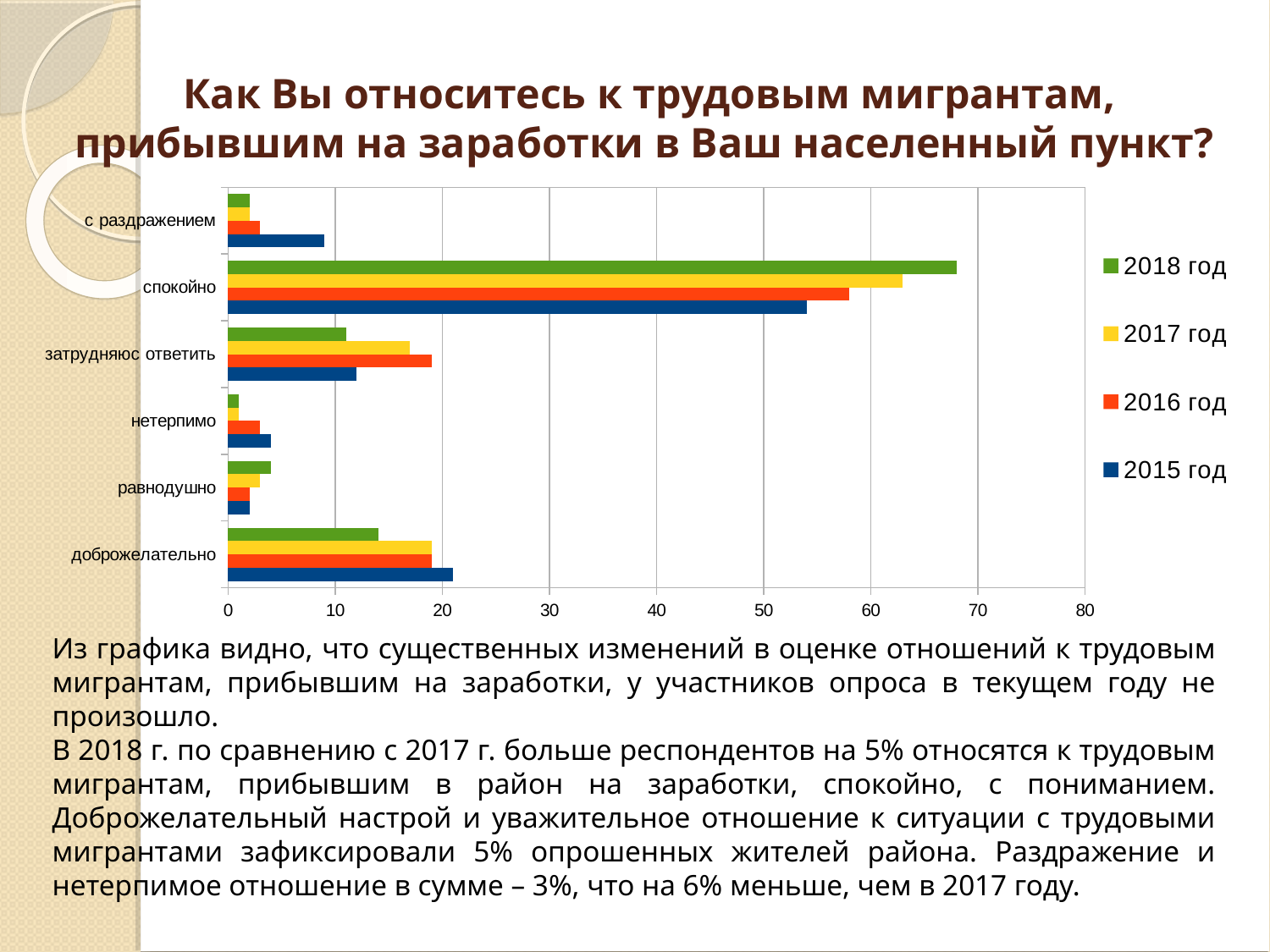
What colour represents 2018 год in the chart? green Is the value for спокойно in 2015 год greater or less than 60? less Is the value for затрудняюс ответить in 2016 год greater or less than 10? greater Which category has the highest value for 2018 год? спокойно Which category has the lowest value for 2015 год? равнодушно What kind of chart is shown on the slide? bar chart How many answer categories are shown on the chart? 6 Is the value for с раздражением in 2015 год greater or less than 5? greater For доброжелательно, which year has the larger value: 2018 год or 2015 год? 2015 год How many series does the legend list? 4 For спокойно, which year has the larger value: 2018 год or 2015 год? 2018 год